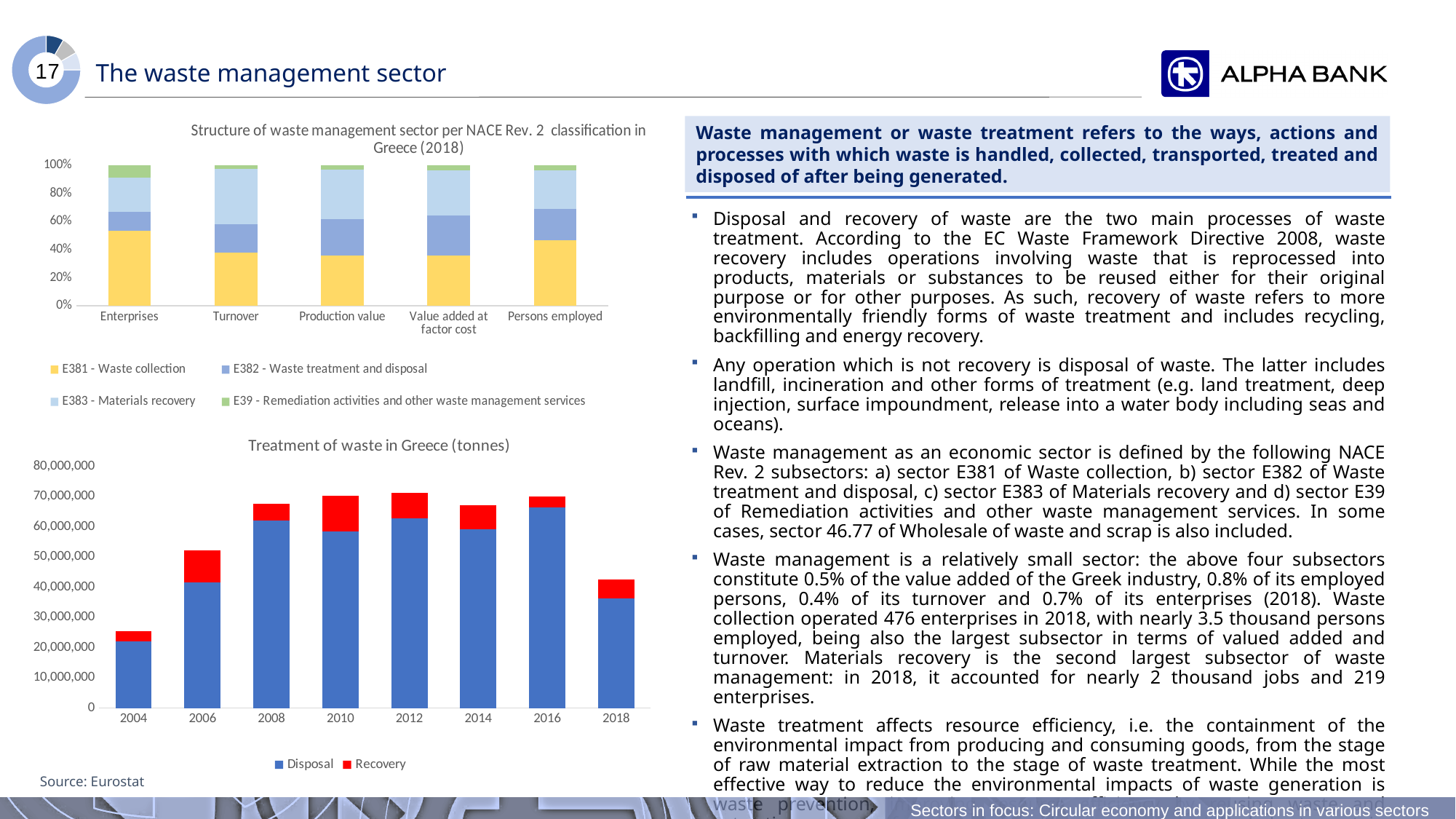
In the 'Treatment of waste in Greece (tonnes)' chart, which is larger: the Disposal value for 2006 or for 2018? 2006 In the 'Treatment of waste in Greece (tonnes)' chart, which year has the highest Disposal value? 2016 In the 'Treatment of waste in Greece (tonnes)' chart, is the Disposal value for 2018 greater or less than 40,000,000? less In the 'Treatment of waste in Greece (tonnes)' chart, which year has the lowest total treated waste? 2004 In the 'Structure of waste management sector per NACE Rev. 2 classification in Greece (2018)' chart, is the share of E381 - Waste collection for Production value greater or less than 40%? less In the 'Treatment of waste in Greece (tonnes)' chart, which colour represents Recovery? Red What type of chart is the 'Treatment of waste in Greece (tonnes)' chart? Stacked bar chart How many years are shown on the x axis of the 'Treatment of waste in Greece (tonnes)' chart? 8 How many series does the legend of the 'Treatment of waste in Greece (tonnes)' chart list? 2 In the 'Treatment of waste in Greece (tonnes)' chart, is the Disposal value for 2008 greater or less than 60,000,000? greater How many series does the legend of the 'Structure of waste management sector per NACE Rev. 2 classification in Greece (2018)' chart list? 4 In the 'Structure of waste management sector per NACE Rev. 2 classification in Greece (2018)' chart, which category has the largest share for E381 - Waste collection? Enterprises